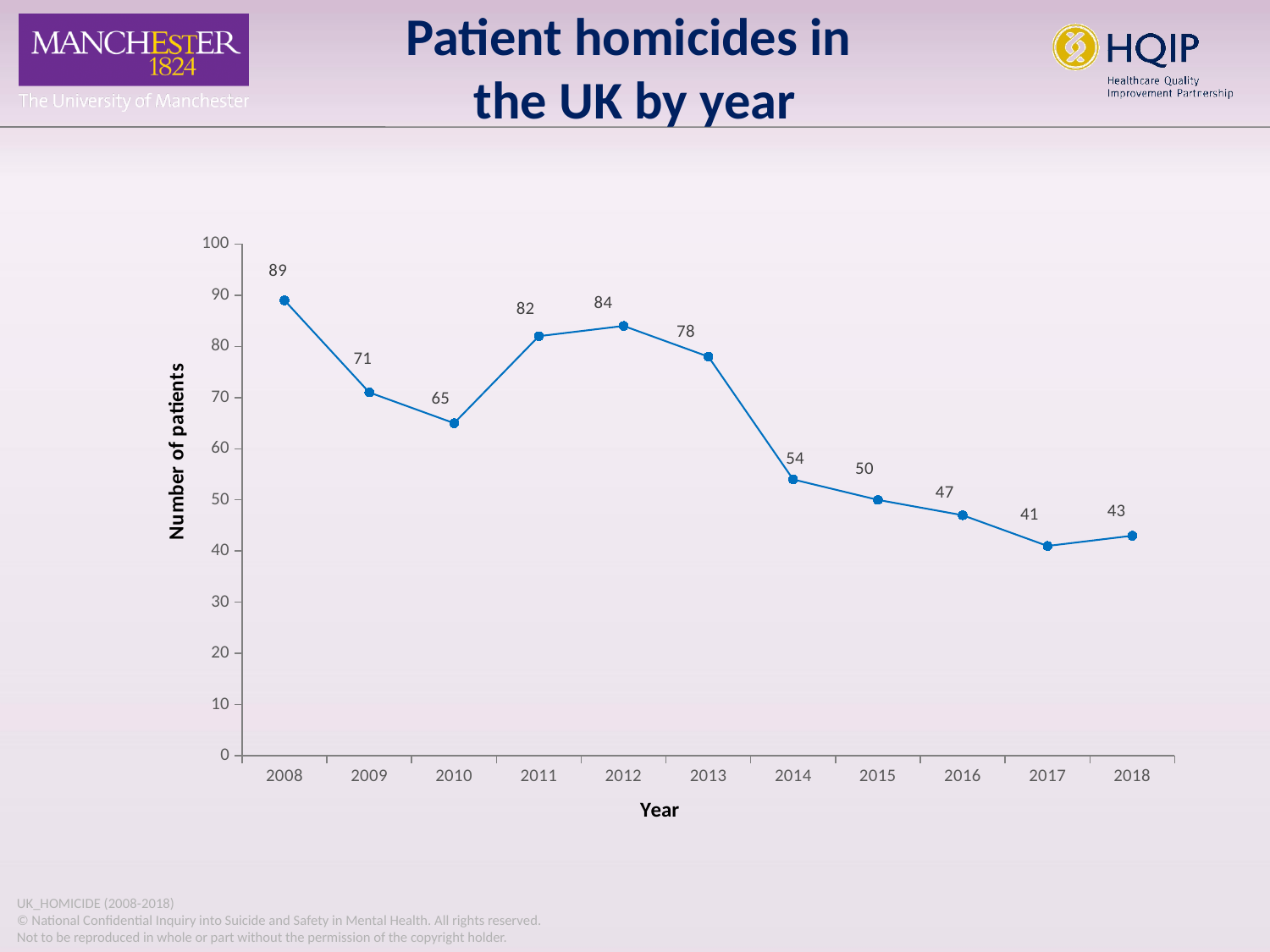
Which year has more patients, 2011 or 2012? 2012 Which year has the highest number of patients? 2008 What is the number of patients in 2014? 54 What is the difference in the number of patients between 2008 and 2018? 46 What is the number of patients in 2008? 89 Which year has the lowest number of patients? 2017 What kind of chart is shown on the slide? Line chart What is the difference in the number of patients between 2012 and 2013? 6 Overall, do the values rise or fall from 2008 to 2018? Fall Is the value for 2010 greater or less than 60? greater What is the number of patients in 2018? 43 How many years are plotted on the chart? 11